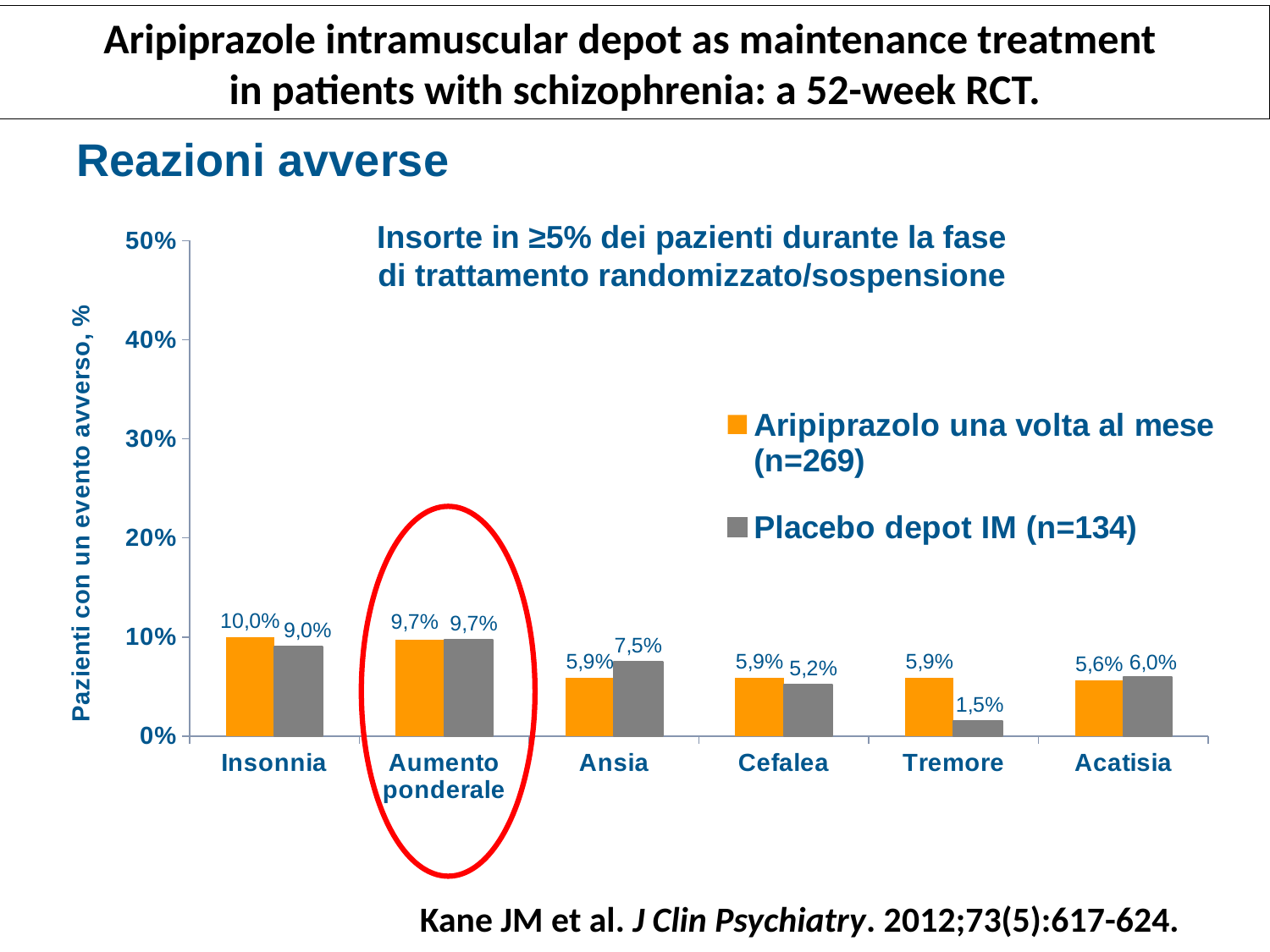
What is the label of the y axis? Pazienti con un evento avverso, % Which category has the lowest value in the Placebo depot IM (n=134) series? Tremore Which category has the highest value in the Aripiprazolo una volta al mese (n=269) series? Insonnia What kind of chart is shown on the slide? bar chart What is the value for Insonnia in the Aripiprazolo una volta al mese (n=269) series? 10,0% What is the value for Tremore in the Placebo depot IM (n=134) series? 1,5% What is the difference between the Aripiprazolo and Placebo values for Tremore? 4,4% How many adverse event categories are shown on the x axis? 6 How many series does the legend list? 2 Is the value for Insonnia in the Aripiprazolo series greater or less than 20%? less What is the value for Ansia in the Placebo depot IM (n=134) series? 7,5% For Ansia, which series has the larger value, Aripiprazolo una volta al mese or Placebo depot IM? Placebo depot IM (n=134)